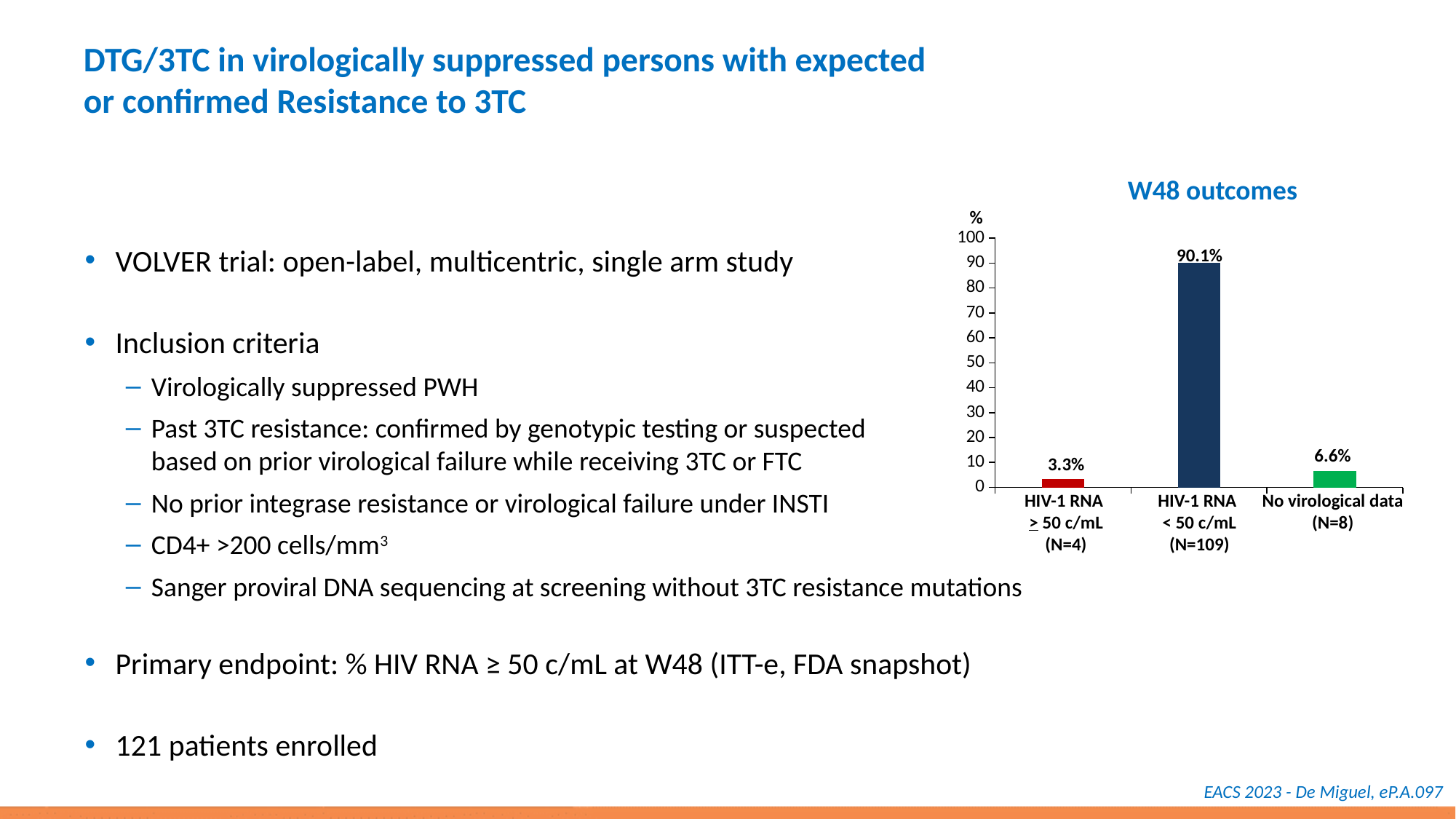
What kind of chart is the W48 outcomes chart? Bar chart Which category has the highest value in the W48 outcomes chart? HIV-1 RNA < 50 c/mL (N=109) Which category has the lowest value in the W48 outcomes chart? HIV-1 RNA ≥ 50 c/mL (N=4) What is the value for HIV-1 RNA ≥ 50 c/mL (N=4) in the W48 outcomes chart? 3.3% What is the difference between the values for No virological data and HIV-1 RNA ≥ 50 c/mL in the W48 outcomes chart? 3.3% What is the value for No virological data (N=8) in the W48 outcomes chart? 6.6% What is the value for HIV-1 RNA < 50 c/mL (N=109) in the W48 outcomes chart? 90.1% How many categories are shown in the W48 outcomes chart? 3 What is the difference between the values for HIV-1 RNA < 50 c/mL and No virological data in the W48 outcomes chart? 83.5% Which is larger in the W48 outcomes chart: the value for No virological data or the value for HIV-1 RNA ≥ 50 c/mL? No virological data What is the title of the chart on the slide? W48 outcomes Is the value for HIV-1 RNA < 50 c/mL in the W48 outcomes chart greater or less than 80? greater